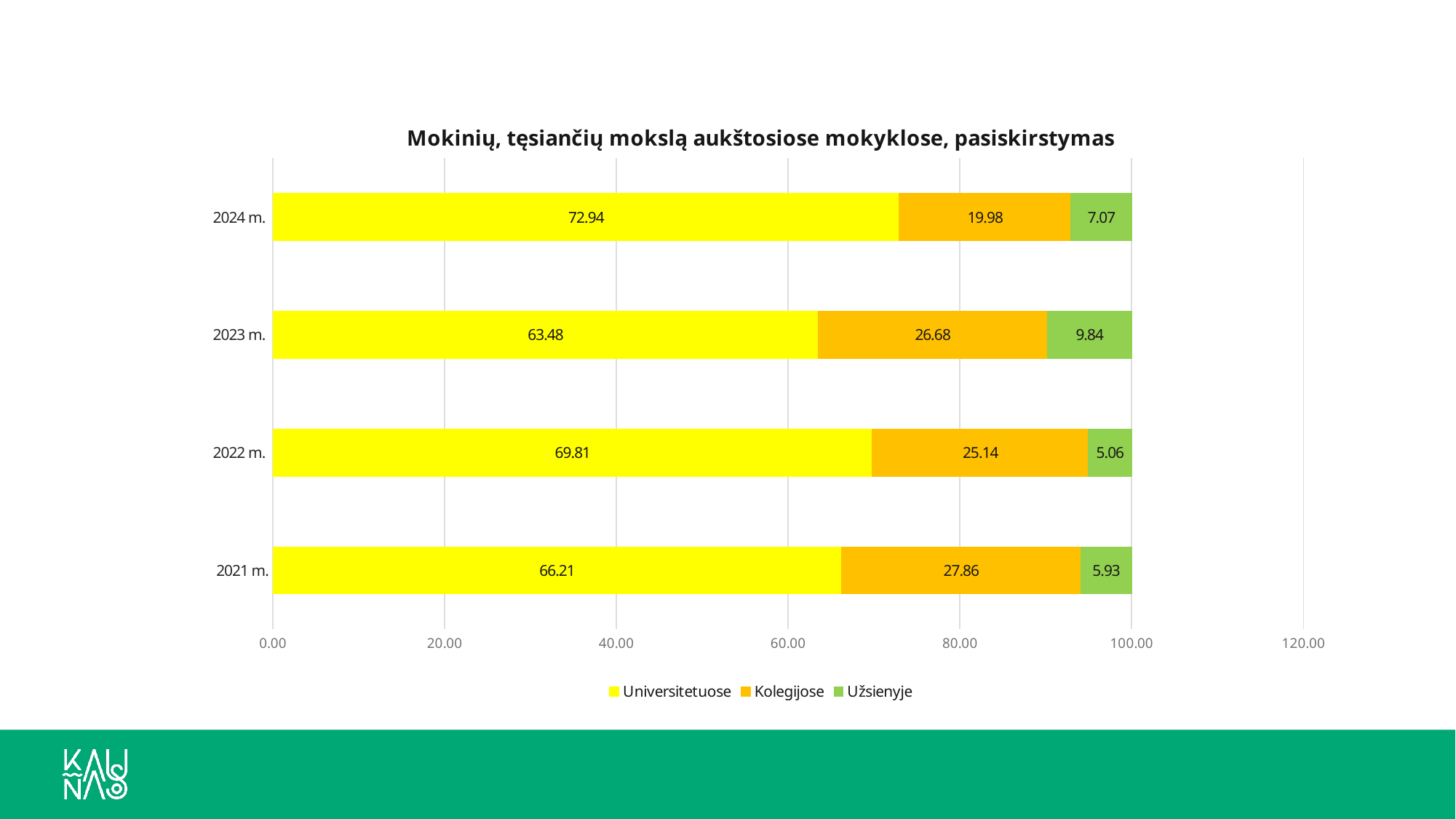
Which is larger, the Universitetuose value for 2022 m. or for 2023 m.? 2022 m. What is the value for Užsienyje in 2023 m.? 9.84 Which series is shown in green in the legend? Užsienyje What is the difference between the Kolegijose values for 2021 m. and 2024 m.? 7.88 What kind of chart is shown on the slide? Stacked bar chart How many years are shown on the chart? 4 How many series does the legend list? 3 What is the value for Universitetuose in 2024 m.? 72.94 What is the value for Kolegijose in 2021 m.? 27.86 What is the total of the stacked bar for 2023 m.? 100.00 Which year has the lowest value for Užsienyje? 2022 m. Which year has the highest value for Universitetuose? 2024 m.